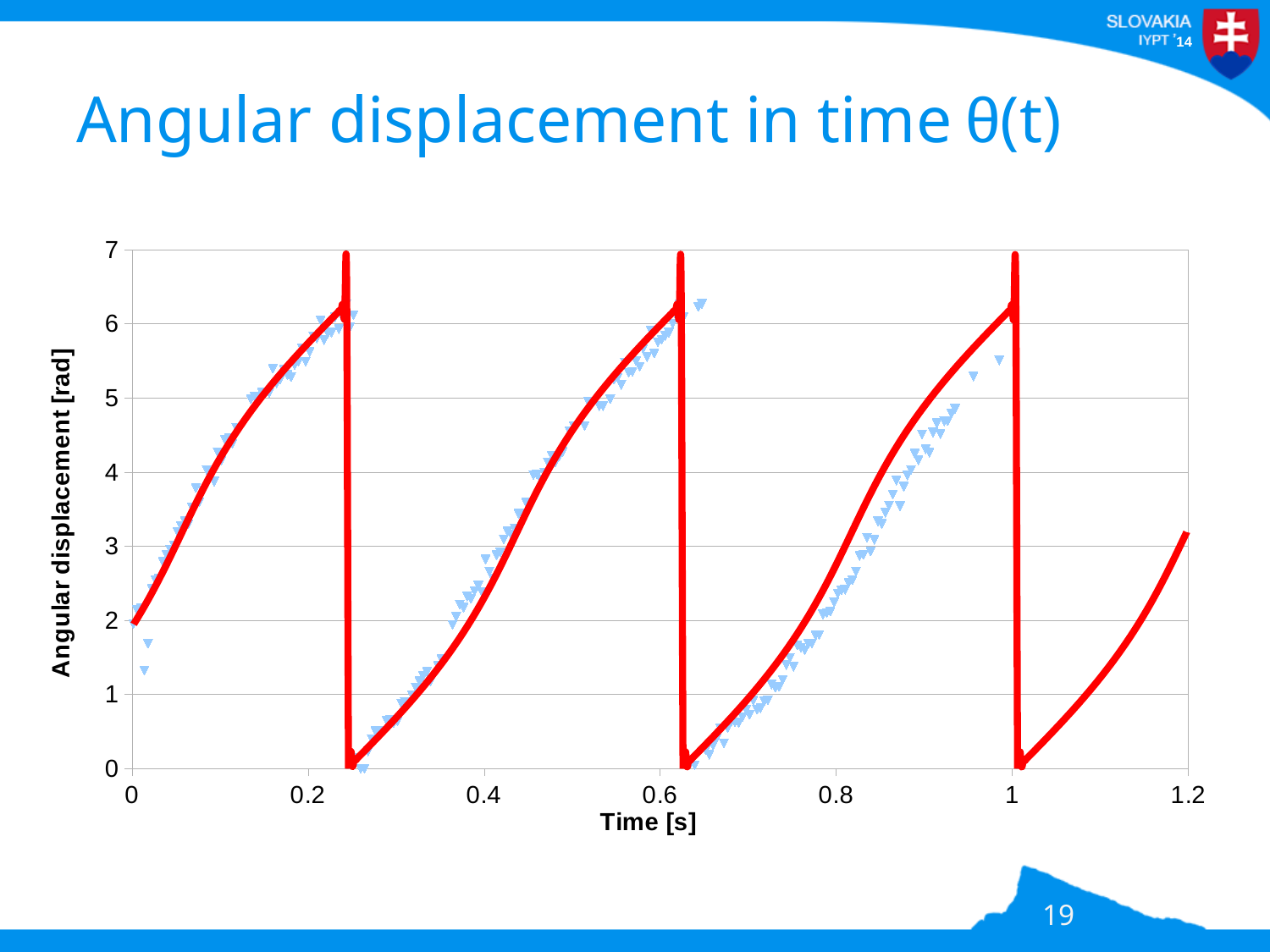
Between time 0.3 s and 0.6 s, does the red line rise or fall? rise What kind of chart is shown on the slide? line chart Is the value of the red line at time 0.9 s greater or less than 4? greater Is the value of the red line at time 0.2 s greater or less than 5? greater Is the value of the red line at time 0.4 s greater or less than 3? less How many sharp vertical drops does the red line show between 0 and 1.2 s? 3 Between time 0 s and 0.2 s, does the red line rise or fall? rise What is the label of the y axis? Angular displacement [rad] What is the label of the x axis? Time [s]